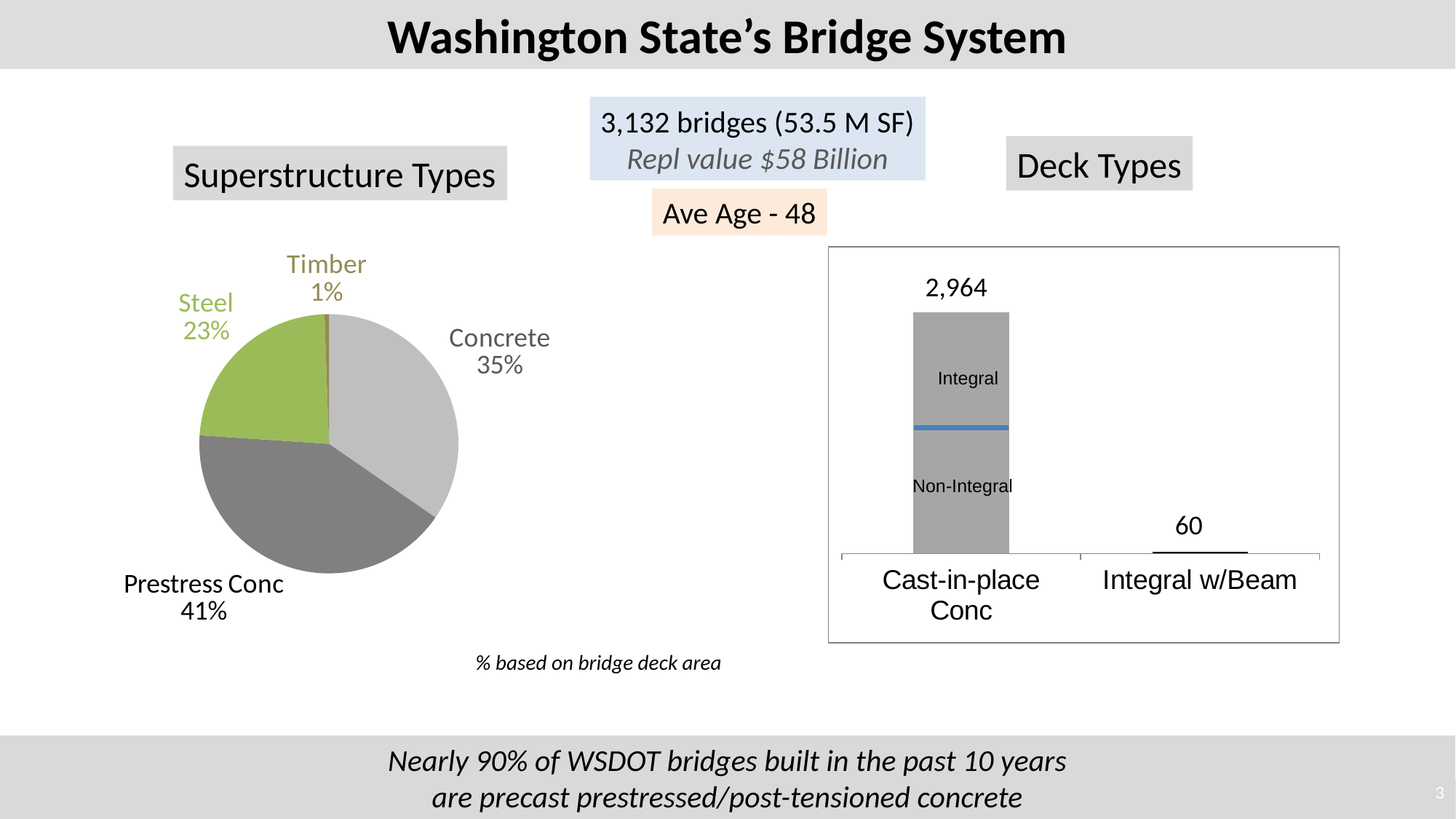
On the Deck Types chart, what is the value for Cast-in-place Conc? 2,964 How many slices does the Superstructure Types pie chart have? 4 On the Superstructure Types pie chart, which superstructure type has the smallest share? Timber On the Superstructure Types pie chart, which is larger, Concrete or Prestress Conc? Prestress Conc On the Superstructure Types pie chart, what share does Steel have? 23% On the Deck Types chart, what is the difference between Cast-in-place Conc and Integral w/Beam? 2,904 On the Deck Types chart, what is the value for Integral w/Beam? 60 On the Superstructure Types pie chart, which superstructure type has the largest share? Prestress Conc What kind of chart is the Superstructure Types chart? Pie chart On the Superstructure Types pie chart, what is the difference in percentage points between Concrete and Steel? 12 On the Superstructure Types pie chart, what share does Prestress Conc have? 41% What kind of chart is the Deck Types chart? Bar chart